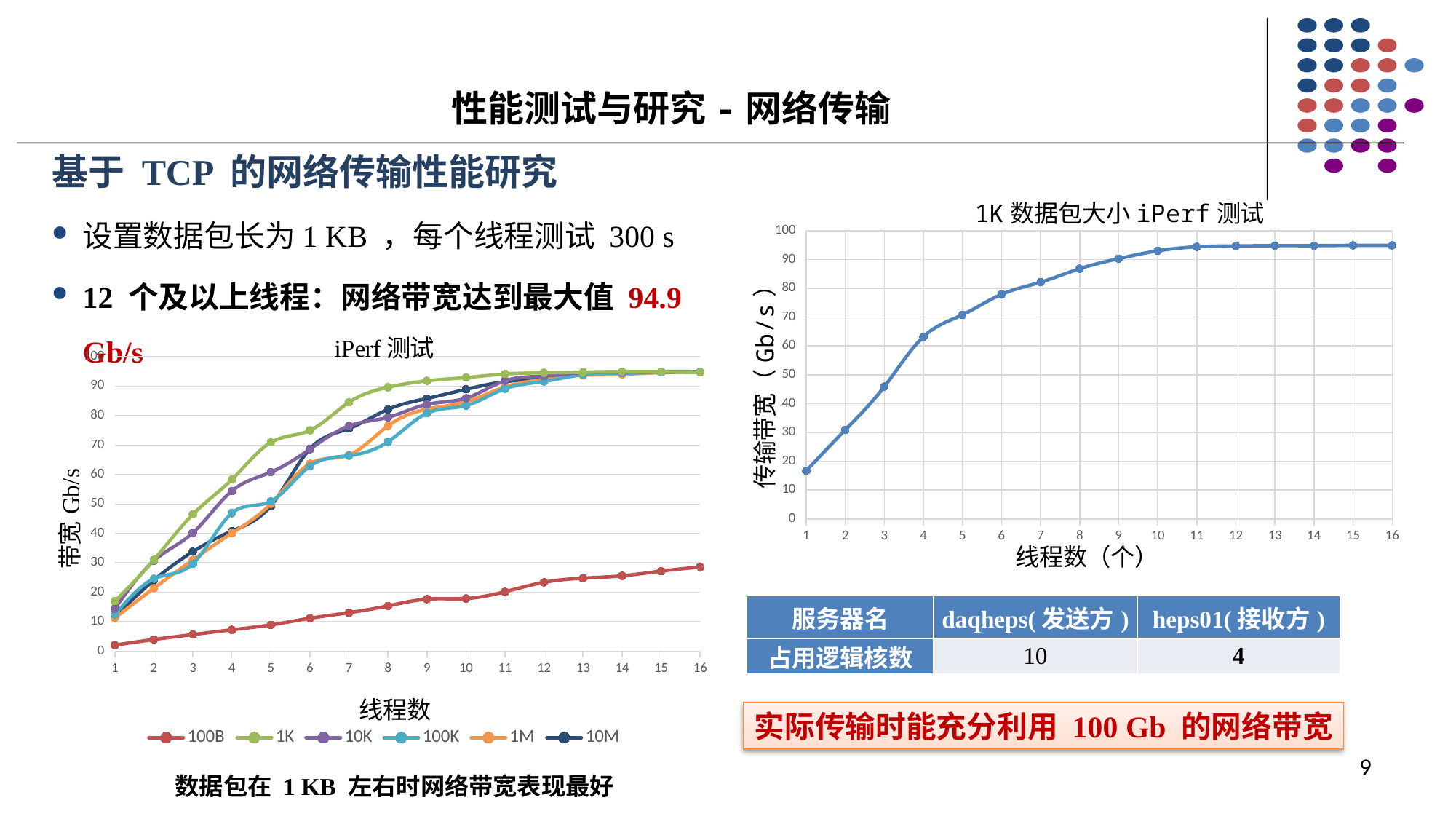
In the left chart "iPerf 测试", is the value for the 1K series at 8 threads greater or less than 80? greater How many series does the legend of the left chart "iPerf 测试" list? 6 What is the x-axis label of the right chart "1K 数据包大小 iPerf 测试"? 线程数（个） In the left chart "iPerf 测试", is the value for the 100B series at 16 threads greater or less than 30? less In the right chart "1K 数据包大小 iPerf 测试", is the value at 10 threads greater or less than 90? greater In the left chart "iPerf 测试", which series has the highest bandwidth at 6 threads? 1K In the left chart "iPerf 测试", which series has the lowest bandwidth at 16 threads? 100B In the right chart "1K 数据包大小 iPerf 测试", does the bandwidth rise or fall as the number of threads increases from 1 to 16? rise What kind of chart is the left chart titled "iPerf 测试"? line chart How many thread-count points are plotted along the x axis of the right chart "1K 数据包大小 iPerf 测试"? 16 In the left chart "iPerf 测试", at 7 threads, which series has the larger bandwidth, 1K or 100K? 1K